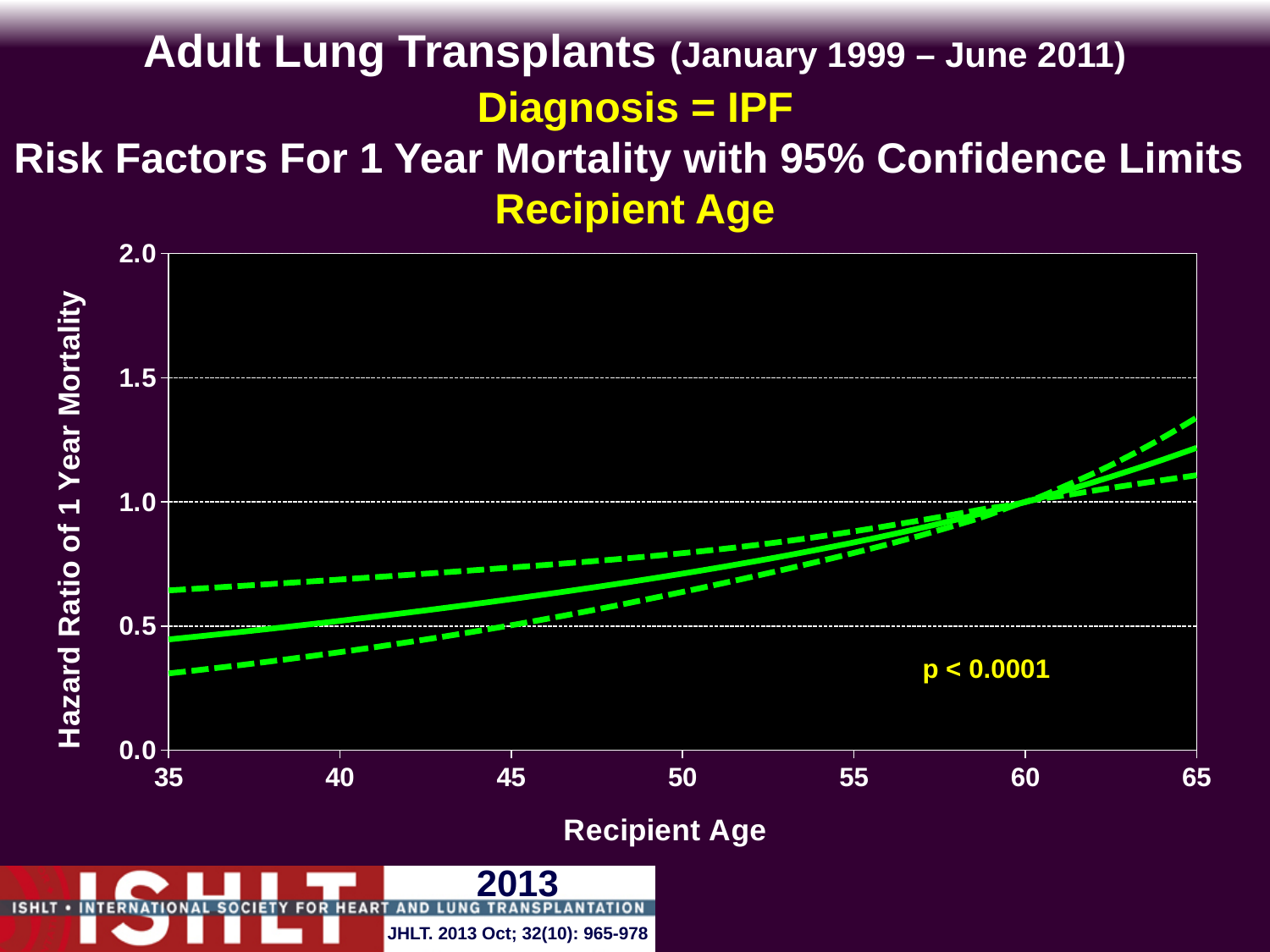
What is the label of the x axis? Recipient Age Is the hazard ratio (solid line) at recipient age 65 greater or less than 1.0? greater Is the upper confidence limit (upper dashed line) at recipient age 35 greater or less than 0.5? greater What kind of chart is shown on the slide? line chart Is the lower confidence limit (lower dashed line) at recipient age 35 greater or less than 0.5? less How many lines are plotted on the chart? 3 What p-value is shown on the chart? p < 0.0001 Does the hazard ratio of 1 year mortality rise or fall as recipient age increases from 35 to 65? rise